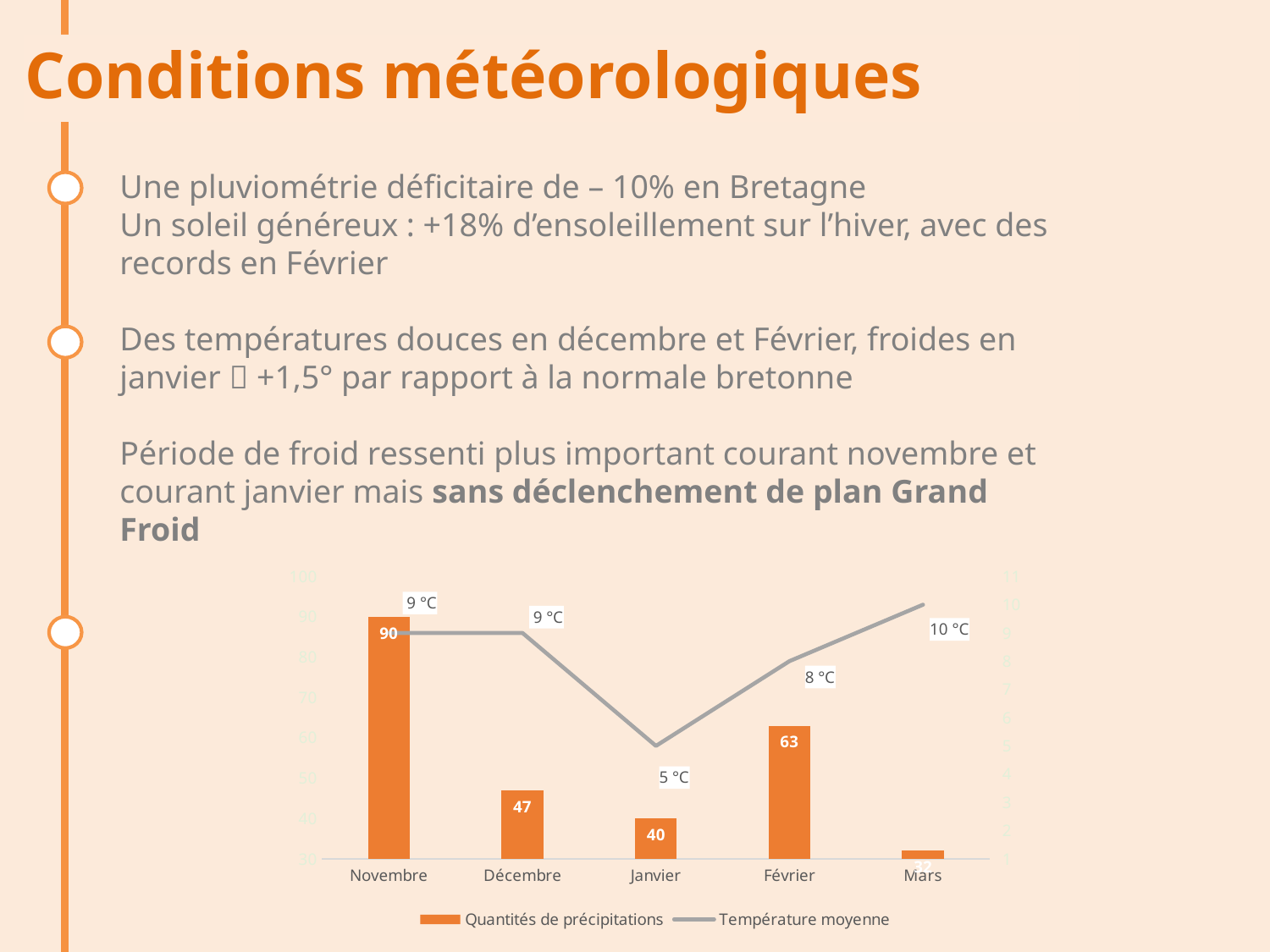
How many months are shown on the x axis of the chart? 5 What kind of chart is shown on the slide? Combination bar and line chart What is the value of Quantités de précipitations for Février? 63 What is the difference in Quantités de précipitations between Novembre and Décembre? 43 Which has the larger Quantités de précipitations, Février or Janvier? Février Which month has the highest Quantités de précipitations? Novembre What is the Température moyenne for Janvier? 5 °C What is the value of Quantités de précipitations for Novembre? 90 Which month has the lowest Température moyenne? Janvier How many series does the chart legend list? 2 What is the Température moyenne for Mars? 10 °C Which month has the lowest Quantités de précipitations? Mars